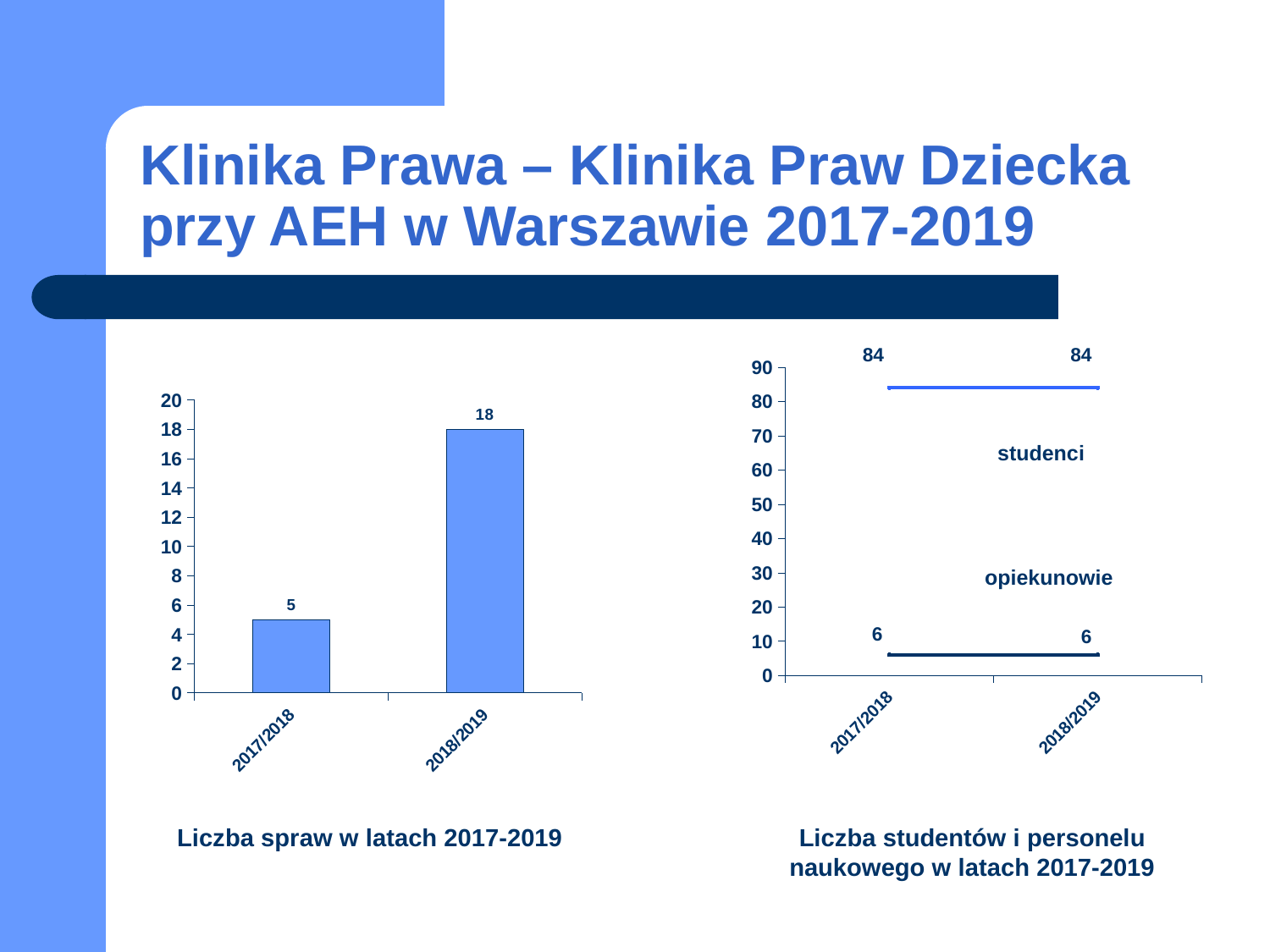
In the left chart (Liczba spraw w latach 2017-2019), do the values rise or fall from 2017/2018 to 2018/2019? rise In the right chart (Liczba studentów i personelu naukowego w latach 2017-2019), which series has the larger values, studenci or opiekunowie? studenci In the left chart (Liczba spraw w latach 2017-2019), what is the value for 2017/2018? 5 In the right chart (Liczba studentów i personelu naukowego w latach 2017-2019), what is the value for studenci in 2017/2018? 84 In the left chart (Liczba spraw w latach 2017-2019), which year has the higher value? 2018/2019 In the left chart (Liczba spraw w latach 2017-2019), how many categories are shown on the x axis? 2 In the right chart (Liczba studentów i personelu naukowego w latach 2017-2019), what is the difference between studenci and opiekunowie in 2018/2019? 78 In the right chart (Liczba studentów i personelu naukowego w latach 2017-2019), how many series are plotted? 2 What kind of chart is the left chart (Liczba spraw w latach 2017-2019)? bar chart In the left chart (Liczba spraw w latach 2017-2019), what is the difference between the 2018/2019 and 2017/2018 values? 13 In the right chart (Liczba studentów i personelu naukowego w latach 2017-2019), what is the value for opiekunowie in 2018/2019? 6 In the left chart (Liczba spraw w latach 2017-2019), what is the value for 2018/2019? 18